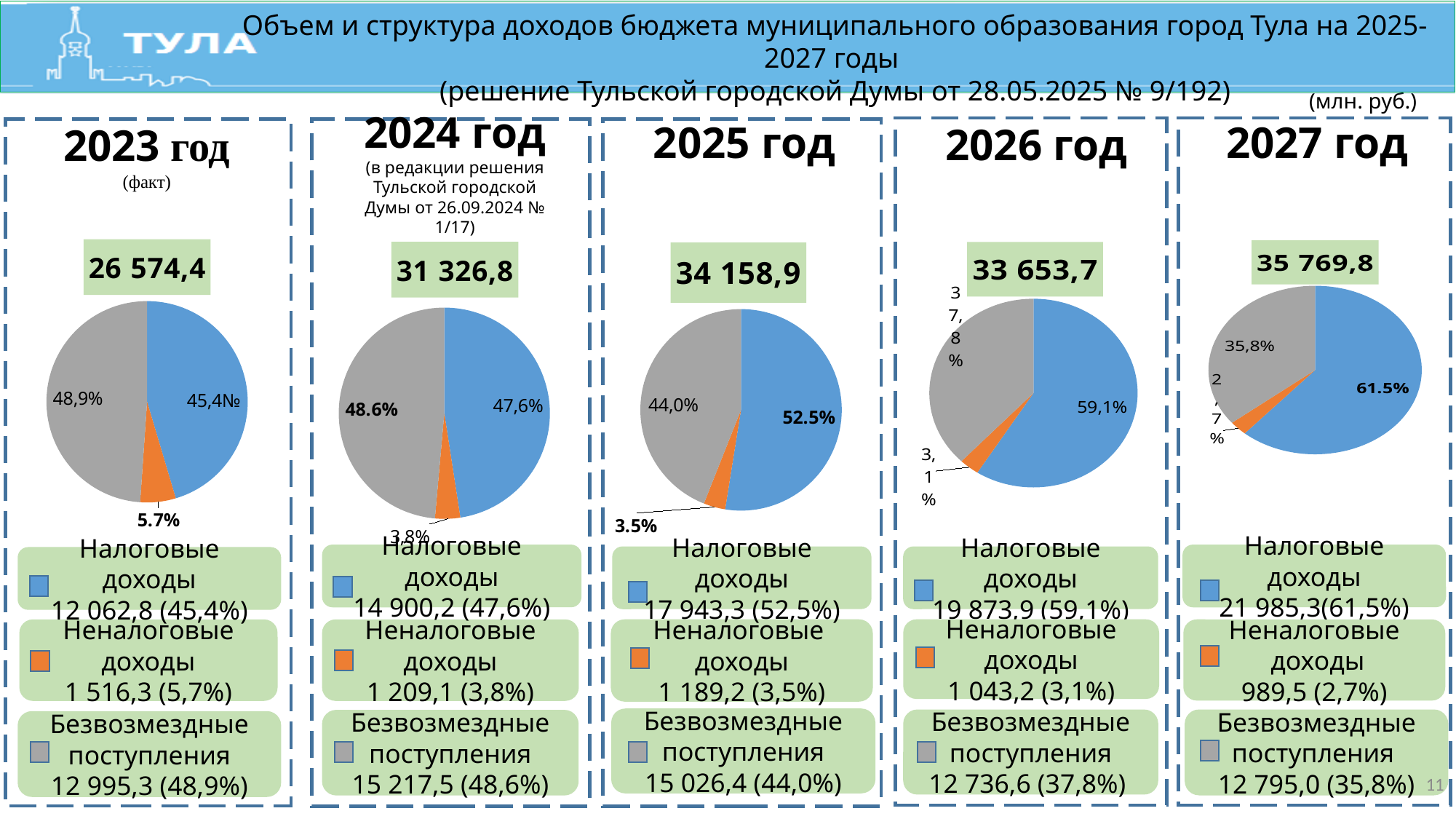
In the 2026 год pie chart, which category has the largest slice? Налоговые доходы In the 2024 год pie chart, what share is labelled for Неналоговые доходы? 3,8% Which colour represents Безвозмездные поступления in the pie charts? grey In the 2023 год pie chart, what share is labelled for Безвозмездные поступления? 48,9% According to the legend of the 2027 год chart, what is the value of Неналоговые доходы? 989,5 (2,7%) In the 2027 год pie chart, what share is labelled for Налоговые доходы? 61,5% How many slices does the 2025 год pie chart have? 3 In the 2025 год pie chart, what is the difference in percentage points between the Налоговые доходы share and the Безвозмездные поступления share? 8,5 In the 2025 год pie chart, which is larger: Налоговые доходы or Безвозмездные поступления? Налоговые доходы What total value is shown above the 2026 год pie chart? 33 653,7 In the 2023 год pie chart, which category has the smallest slice? Неналоговые доходы What kind of chart is used for each year on the slide? pie chart